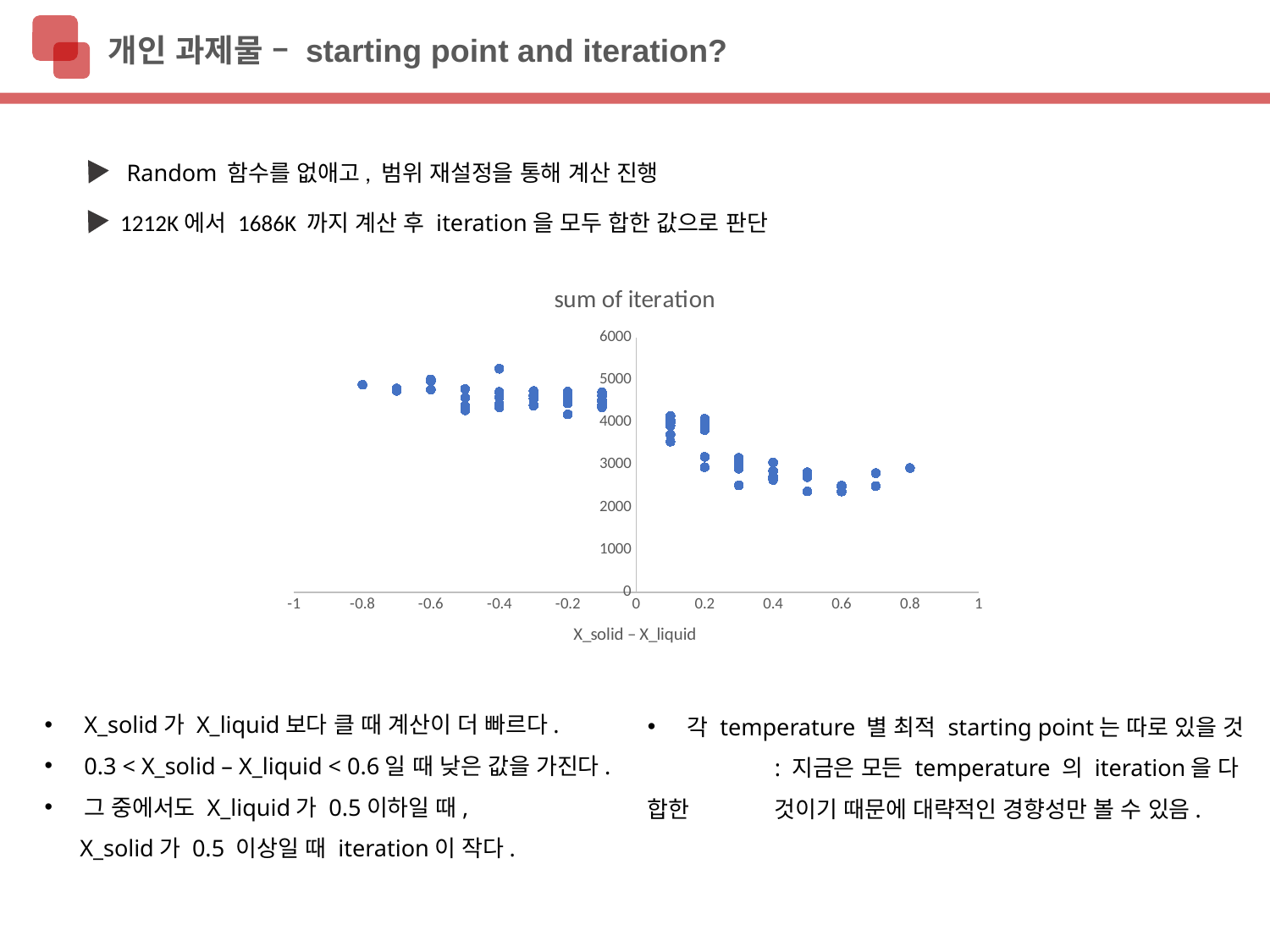
What is the highest value shown on the y axis of the chart? 6000 What kind of chart is shown on the slide? scatter chart Are the values plotted at X_solid – X_liquid = -0.4 greater or less than 3000? greater What is the label of the x axis of the chart? X_solid – X_liquid What is the title of the chart? sum of iteration Do the plotted values generally rise or fall as X_solid – X_liquid increases from -0.8 to 0.8? fall Are the values plotted at X_solid – X_liquid = 0.5 greater or less than 4000? less Which has the smaller plotted values, X_solid – X_liquid = -0.6 or X_solid – X_liquid = 0.4? 0.4 Which has the larger plotted values, X_solid – X_liquid = -0.8 or X_solid – X_liquid = 0.6? -0.8 Is the value plotted at X_solid – X_liquid = -0.8 greater or less than 4000? greater